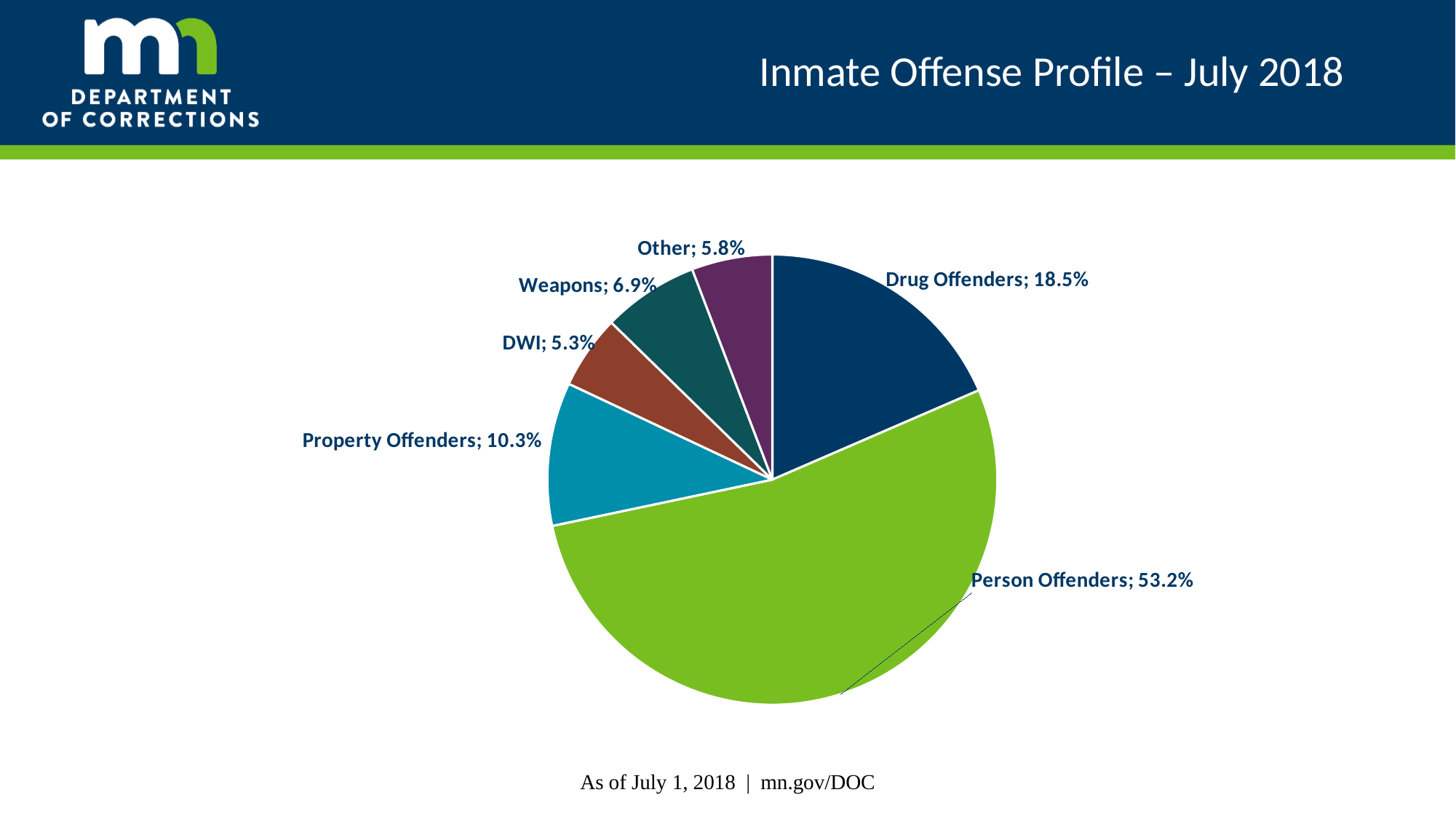
What kind of chart is shown on the slide? pie chart What percentage is shown for DWI? 5.3% What percentage is shown for Drug Offenders? 18.5% What share of inmates are Person Offenders? 53.2% What is the title of the slide containing the chart? Inmate Offense Profile – July 2018 Which category has the largest slice of the pie? Person Offenders What is the difference in percentage points between Drug Offenders and Property Offenders? 8.2 What percentage is shown for Weapons? 6.9% What percentage is shown for Property Offenders? 10.3% Which is larger, the Weapons slice or the Other slice? Weapons How many categories are shown in the pie chart? 6 Which category has the smallest slice of the pie? DWI